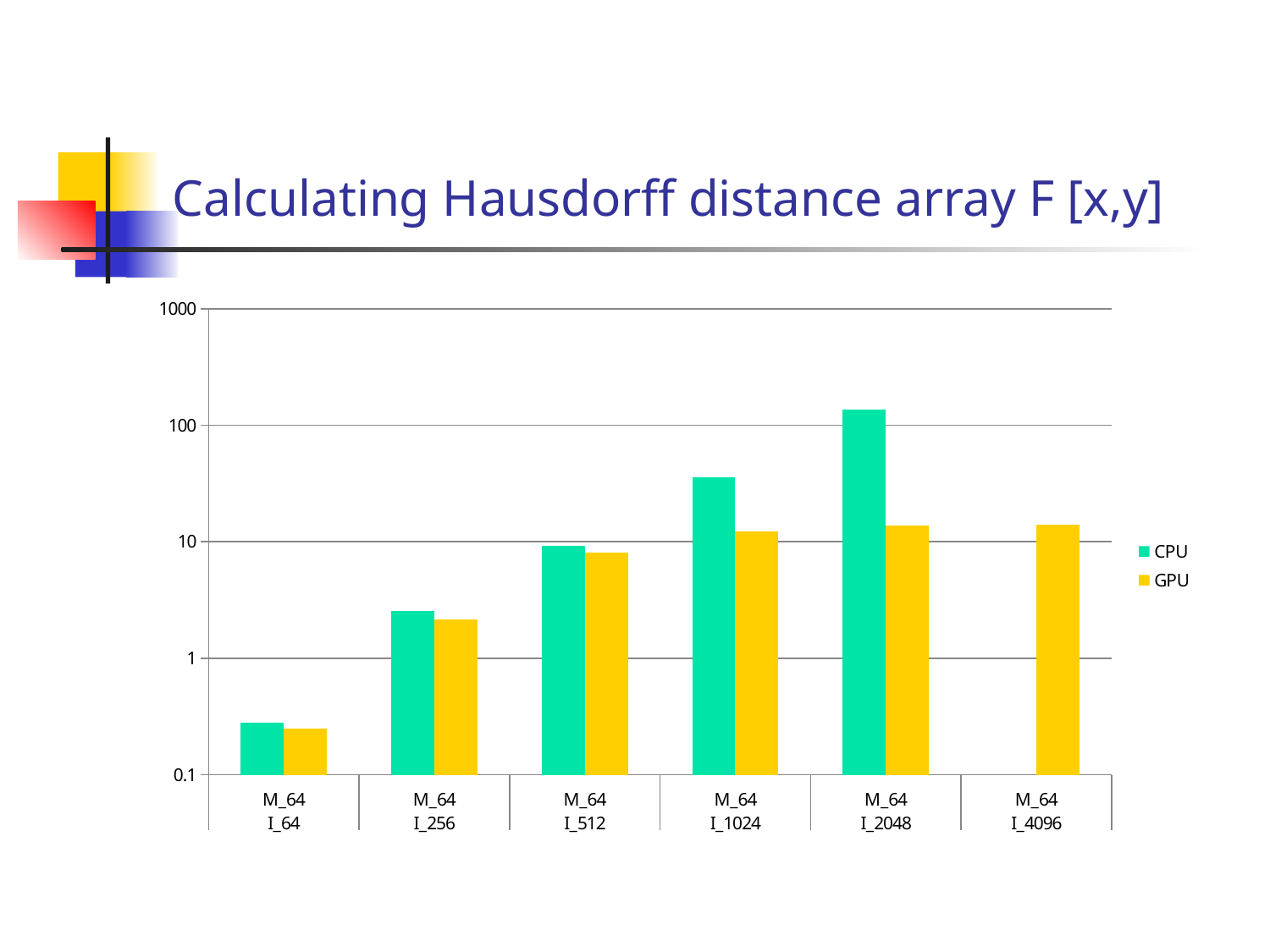
Is the CPU value for M_64 I_2048 greater or less than 100? greater Which is larger for M_64 I_2048, the CPU value or the GPU value? CPU Which category has the highest CPU value? M_64 I_2048 What kind of chart is shown on the slide? bar chart How many categories are shown on the x axis? 6 Which category has no CPU bar? M_64 I_4096 Is the GPU value for M_64 I_64 greater or less than 1? less Which category has the lowest GPU value? M_64 I_64 How many series does the legend list? 2 Is the CPU value for M_64 I_1024 greater or less than 10? greater Which category has the lowest CPU value? M_64 I_64 Do the CPU values rise or fall from M_64 I_64 to M_64 I_2048? rise